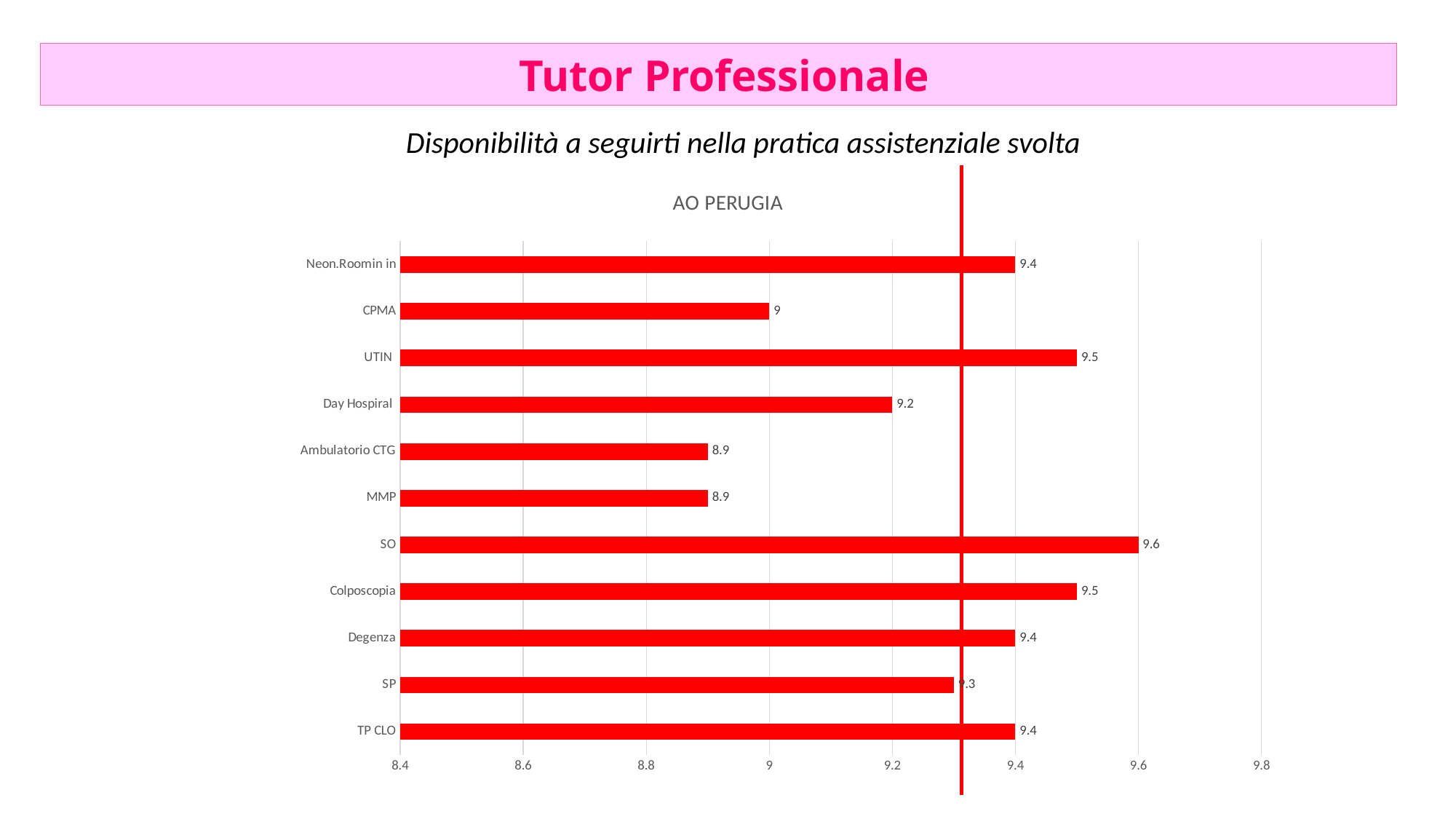
What colour are the bars in the chart? red What is the value for UTIN? 9.5 Which is larger, the value for Colposcopia or the value for Degenza? Colposcopia What is the title of the chart? AO PERUGIA What is the difference between the values for SO and CPMA? 0.6 Is the value for Ambulatorio CTG greater or less than 9? less What kind of chart is shown on the slide? bar chart What is the value for CPMA? 9 What is the value for SP? 9.3 Which category has the highest value? SO What is the value for Day Hospiral? 9.2 How many categories are shown in the chart? 11